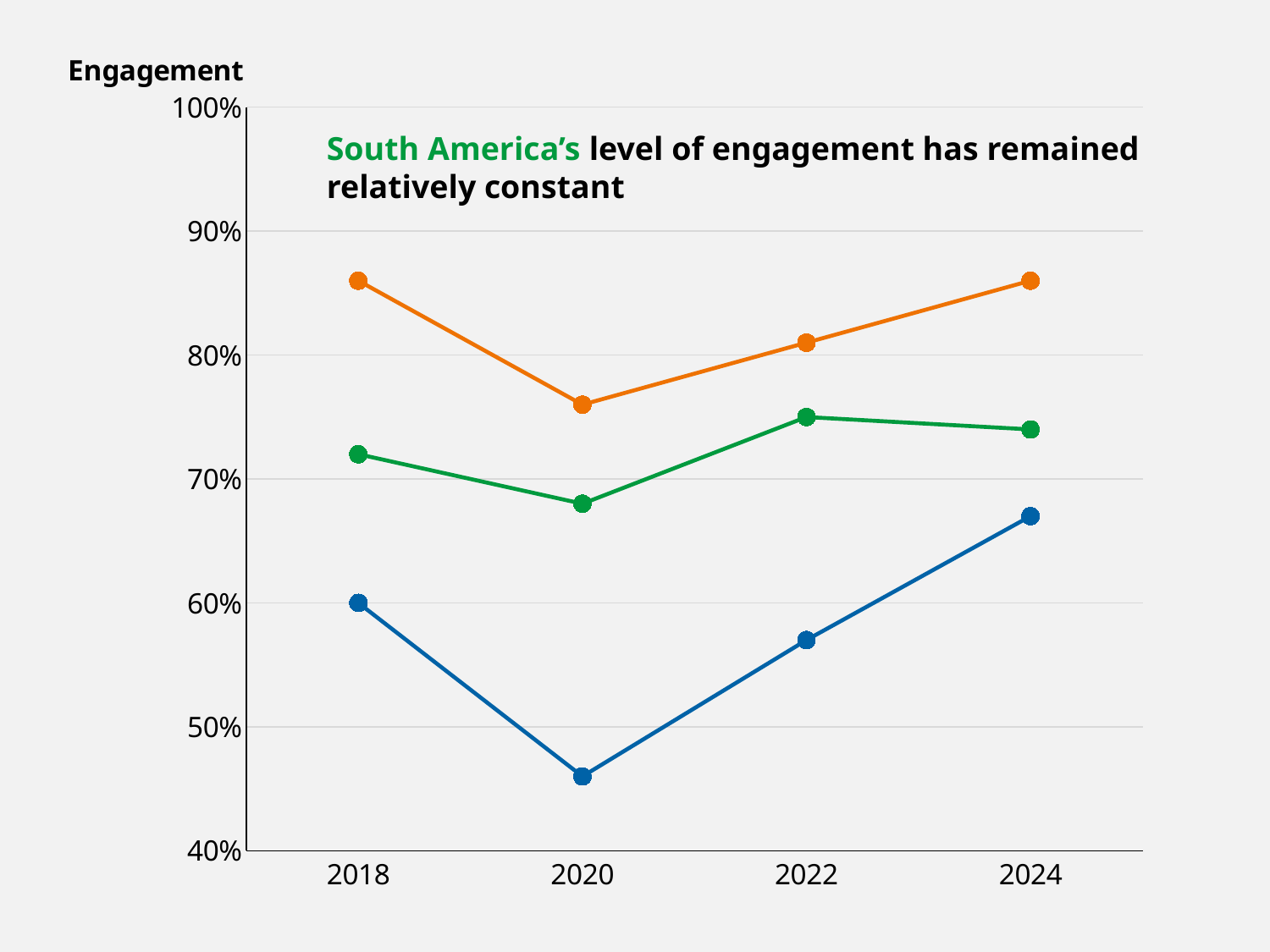
In 2024, which line has the higher value, the orange line or the green (South America) line? orange Is South America's engagement in 2022 greater or less than 70%? greater What is the label on the y axis of the chart? Engagement What kind of chart is shown on the slide? line chart How many years are plotted along the x axis? 4 In which year is South America's engagement lowest? 2020 Is South America's engagement in 2020 greater or less than 70%? less Is the value of the orange line in 2020 greater or less than 80%? less Does the blue line rise or fall from 2020 to 2024? rise Which series is identified by name in the annotation on the chart? South America